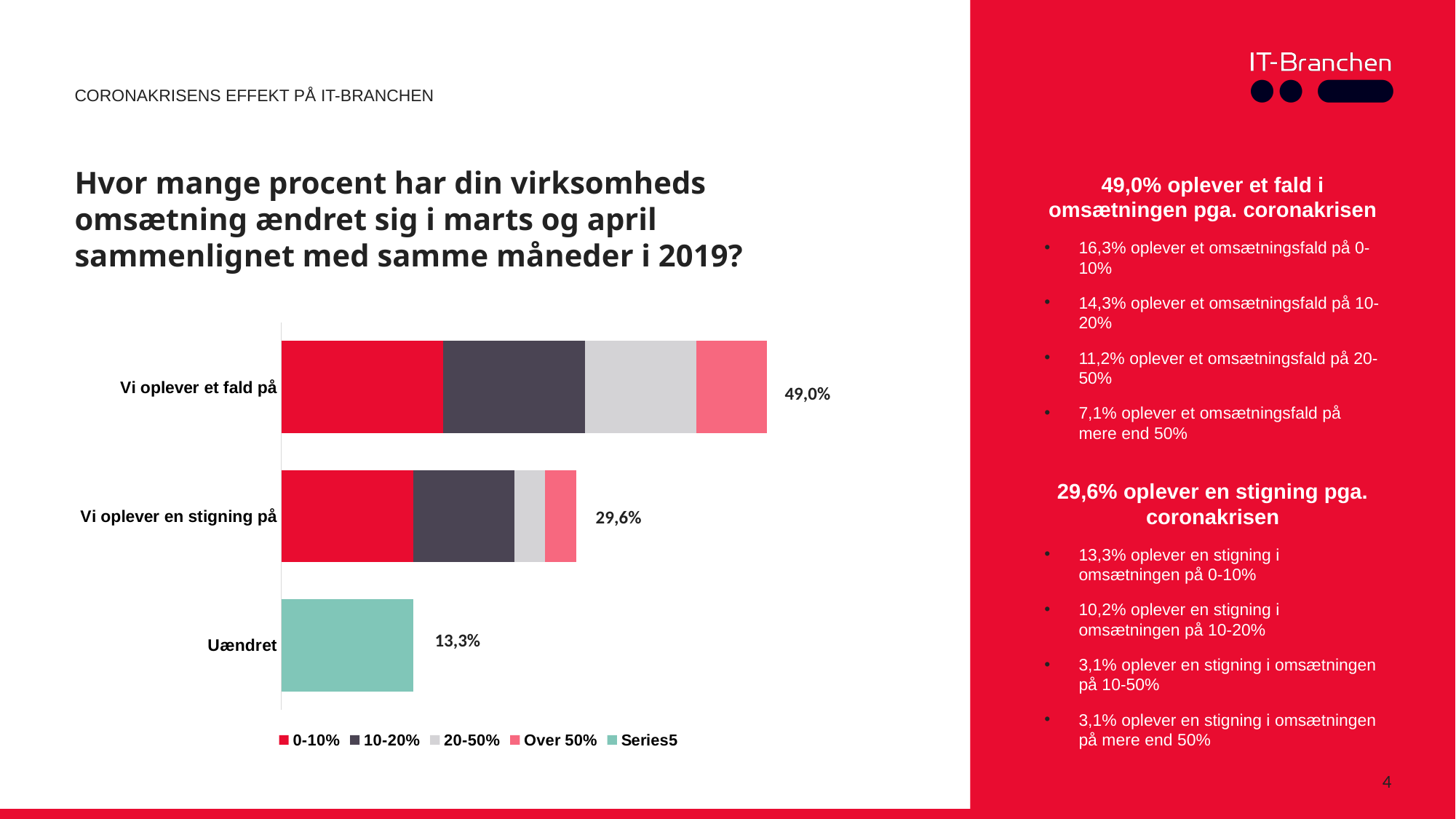
What kind of chart is shown on the slide? Stacked bar chart Which legend entry is shown in bright red? 0-10% How many series does the legend list? 5 How many categories are shown on the chart? 3 Which is larger, the total for "Vi oplever et fald på" or the total for "Vi oplever en stigning på"? Vi oplever et fald på What is the difference between the totals for "Vi oplever et fald på" and "Vi oplever en stigning på"? 19,4% What value is shown for the category "Uændret"? 13,3% Which category has the lowest value? Uændret What is the total value shown for the bar "Vi oplever et fald på"? 49,0% What is the total value shown for the bar "Vi oplever en stigning på"? 29,6% What is the difference between the values for "Vi oplever en stigning på" and "Uændret"? 16,3% Which category has the highest total value? Vi oplever et fald på